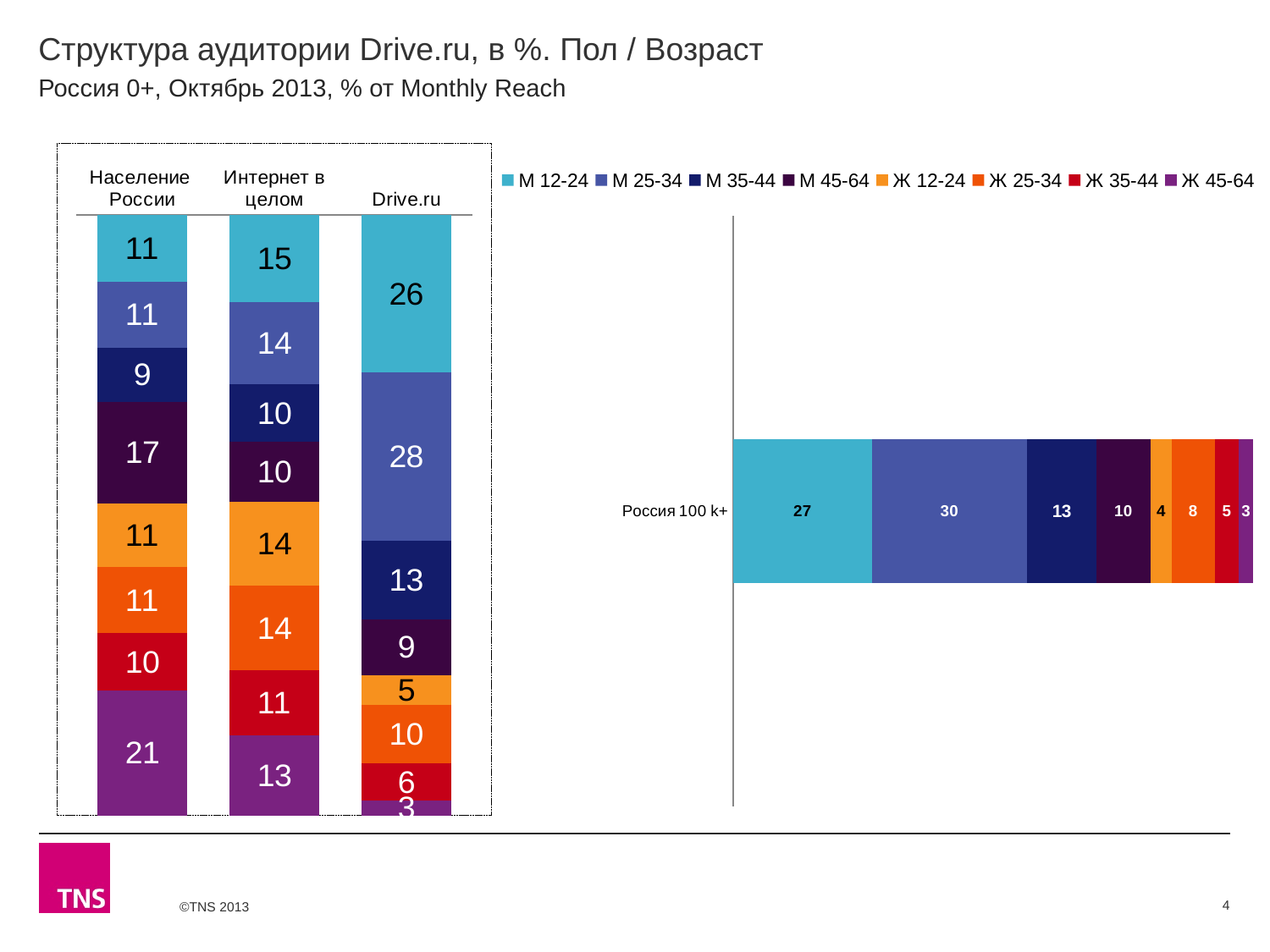
How many series does the legend list? 8 In the left chart, what is the value of the М 12-24 segment for Drive.ru? 26 In the right chart, what is the value of the М 25-34 segment for Россия 100 k+? 30 In the left chart, what is the value of the М 35-44 segment for Интернет в целом? 10 In the left chart, what is the value of the Ж 45-64 segment for Население России? 21 In the left chart, what is the difference between the М 25-34 values for Drive.ru and Население России? 17 In the right chart, which segment is the smallest for Россия 100 k+? Ж 45-64 What type of chart is the right chart? Stacked bar chart In the left chart, which segment is the largest in the Drive.ru bar? М 25-34 In the left chart, which segment is the smallest in the Drive.ru bar? Ж 45-64 How many bars does the left chart show? 3 In the left chart, which is larger: the Ж 25-34 value for Интернет в целом or for Drive.ru? Интернет в целом